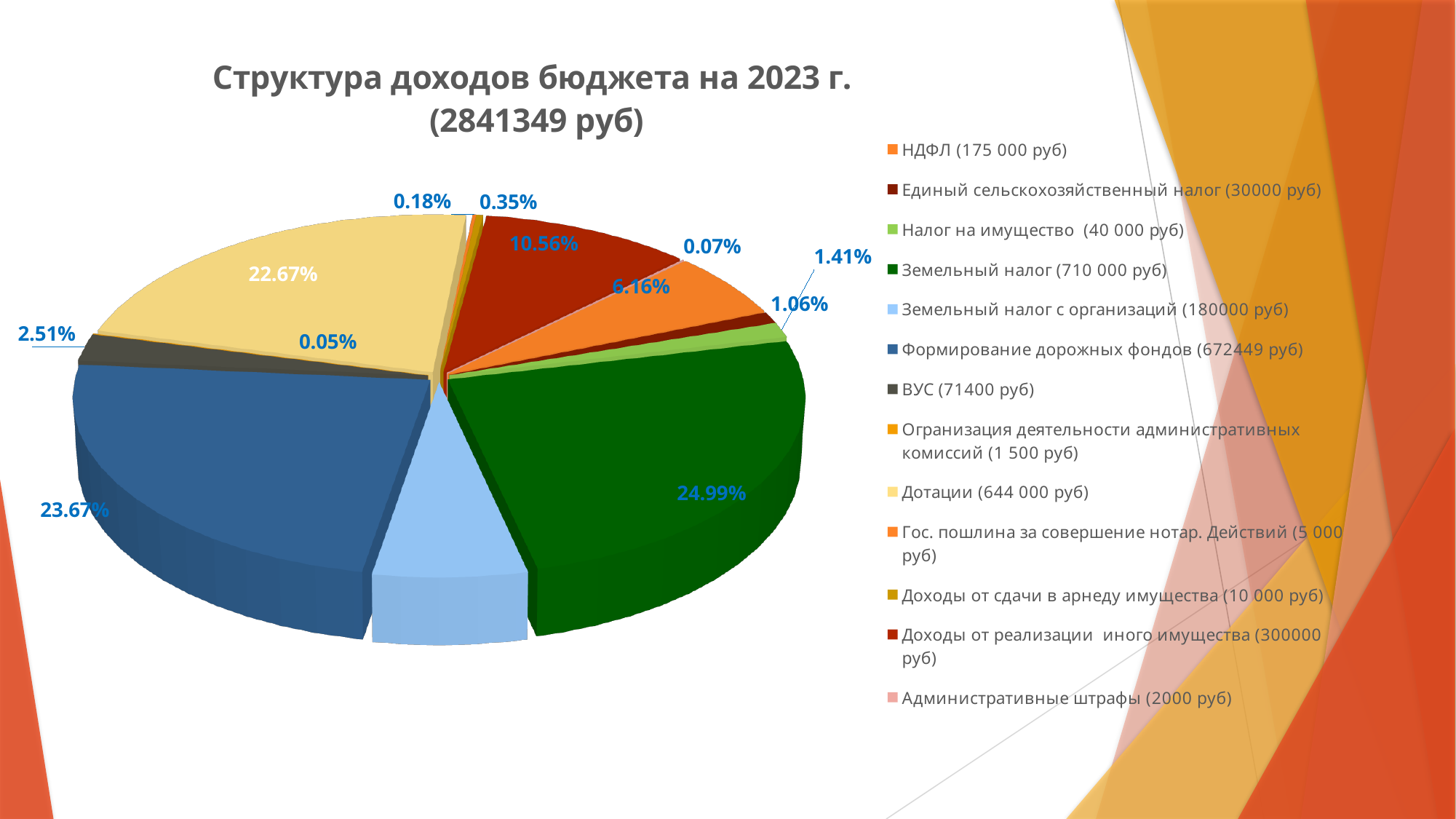
What is the difference in percentage points between the shares of Земельный налог and Формирование дорожных фондов? 1.32 What share of the budget revenue is Доходы от реализации иного имущества? 10.56% What share of the budget revenue is Формирование дорожных фондов? 23.67% What is the title of the chart? Структура доходов бюджета на 2023 г. (2841349 руб) What type of chart is shown on the slide? Pie chart How many categories does the legend list? 13 What share of the budget revenue is Земельный налог? 24.99% Which category has the largest share of the pie? Земельный налог Which category has the smallest share of the pie? Огранизация деятельности административных комиссий